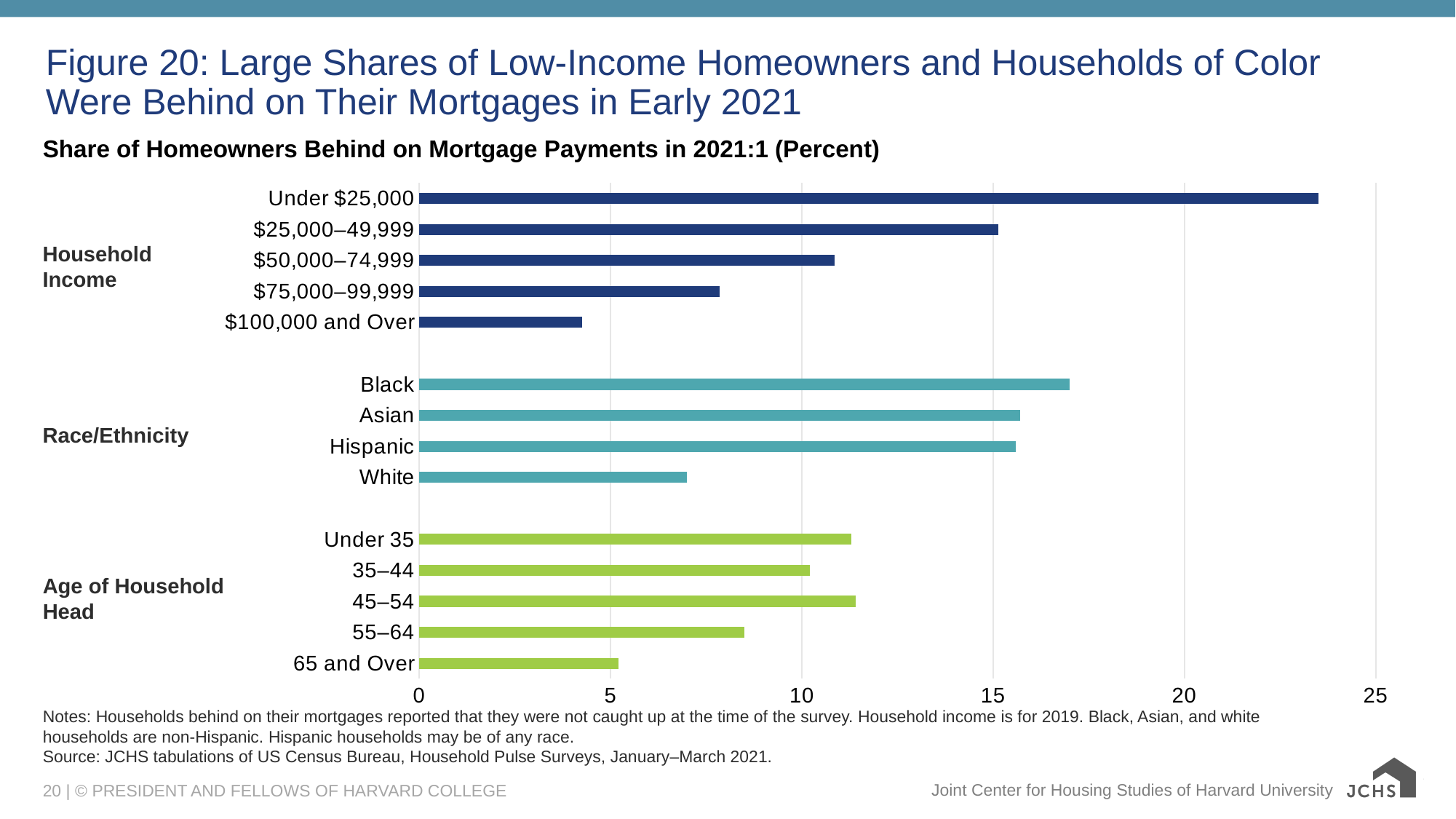
Is the value for White greater or less than 10? less Which has a larger share behind on mortgage payments, $25,000–49,999 or $50,000–74,999? $25,000–49,999 Among the Race/Ethnicity categories, which has the lowest share behind on mortgage payments? White Which category has the lowest share of homeowners behind on mortgage payments? $100,000 and Over Is the value for Under $25,000 greater or less than 20? greater Which category has the highest share of homeowners behind on mortgage payments? Under $25,000 Which has a larger share behind on mortgage payments, Black or White households? Black How many categories are plotted in the chart? 14 What kind of chart is shown on the slide? Bar chart Is the value for Black greater or less than 15? greater Within the Household Income group, do the values rise or fall as income increases? Fall